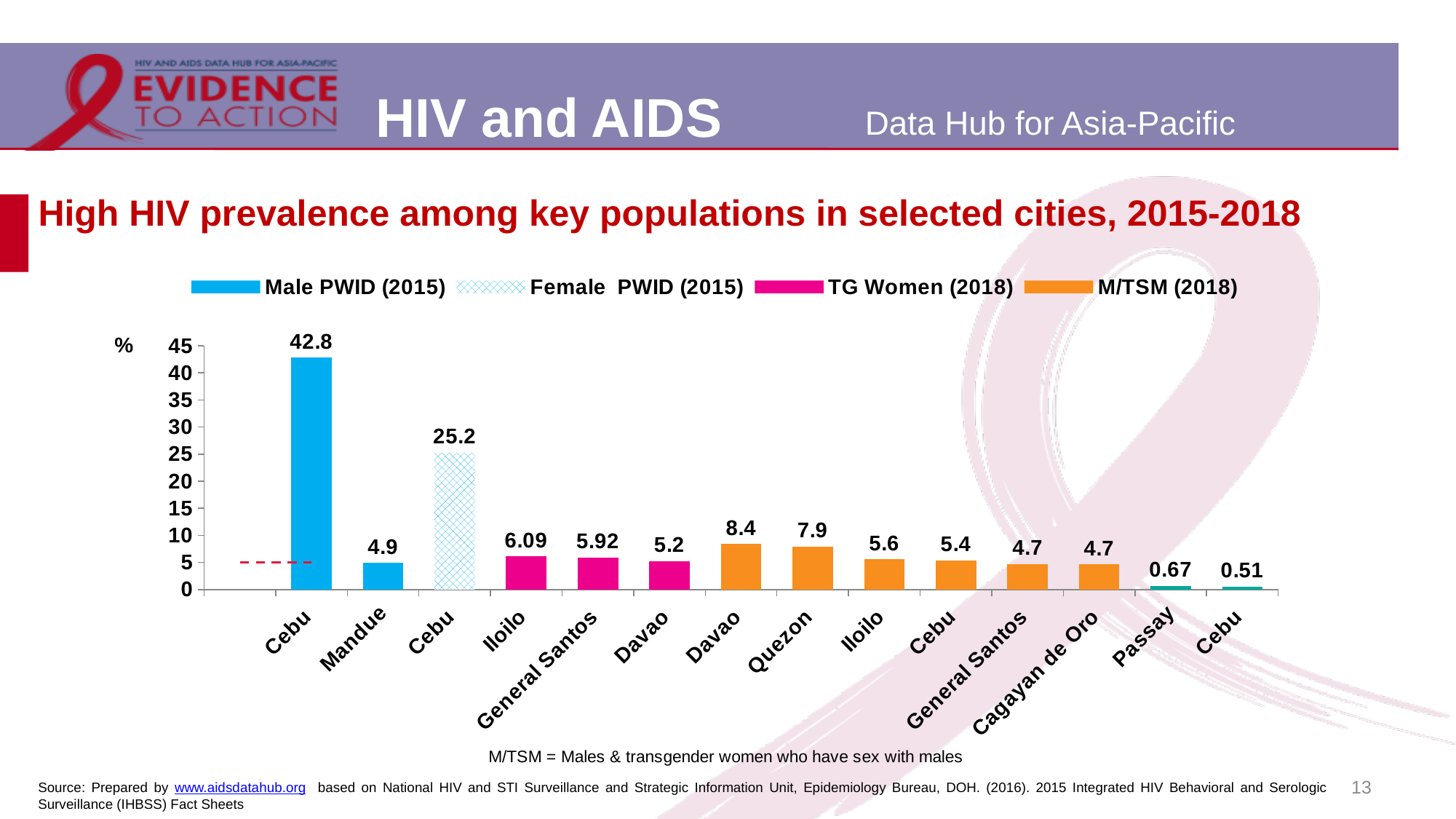
What is the HIV prevalence for M/TSM (2018) in Quezon? 7.9 What is the HIV prevalence for Female PWID (2015) in Cebu? 25.2 How many series does the legend list? 4 What kind of chart is shown on the slide? bar chart How many bars are plotted on the chart? 14 Is the value for Female PWID (2015) in Cebu greater or less than 20? greater Which is larger for M/TSM (2018): Davao or Quezon? Davao Which bar has the highest value on the chart? Cebu, Male PWID (2015) What is the HIV prevalence for Male PWID (2015) in Cebu? 42.8 What is the difference between the Male PWID (2015) values for Cebu and Mandue? 37.9 What is the HIV prevalence for TG Women (2018) in Iloilo? 6.09 Among the M/TSM (2018) bars, which city has the highest value? Davao